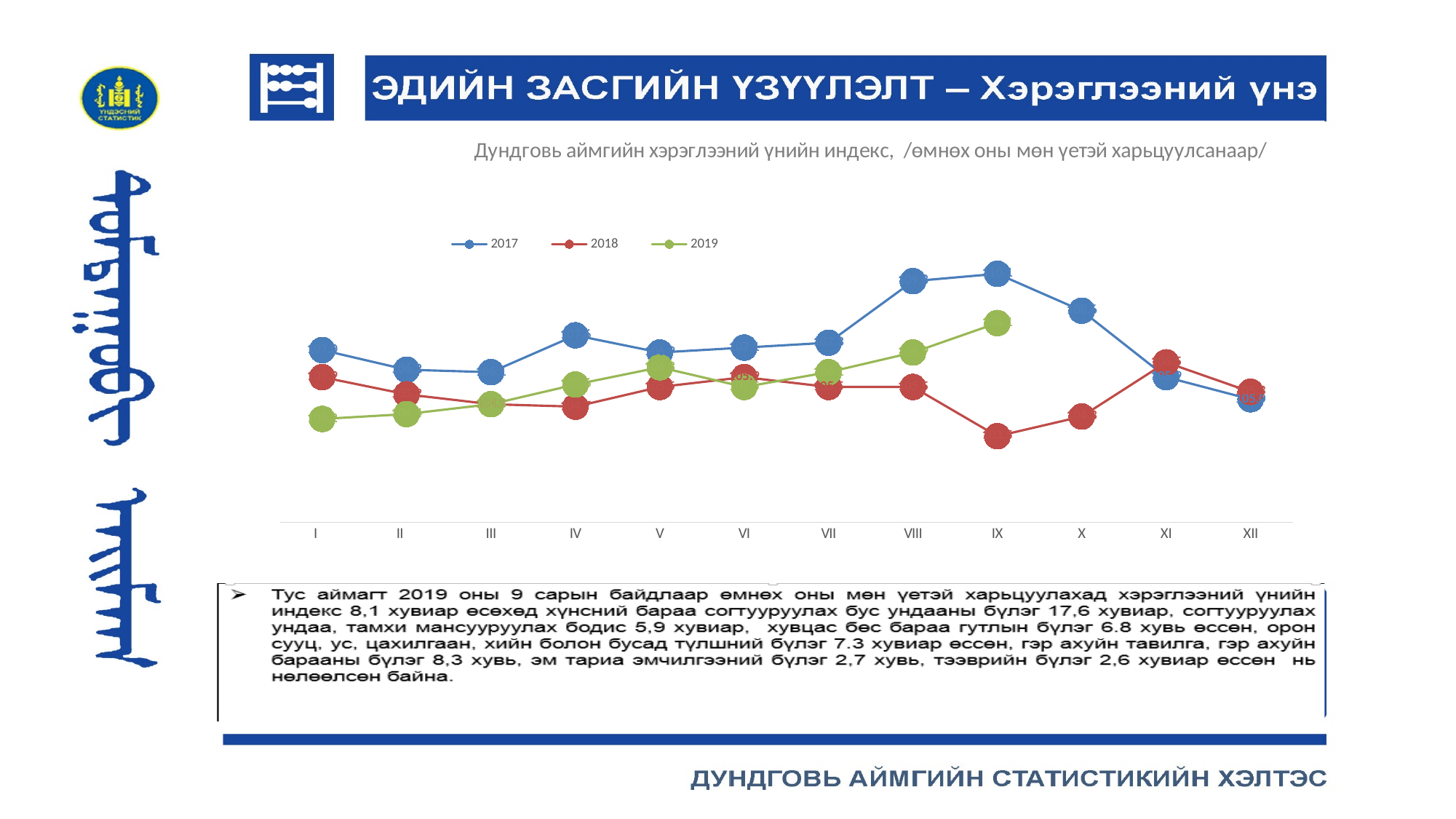
Which years are listed in the chart legend? 2017, 2018, 2019 In month IX, which series has the higher value, 2017 or 2018? 2017 In which month does the 2018 series reach its lowest value? IX In which month does the 2017 series reach its lowest value? XII How many data points does the 2019 series have? 9 In which month does the 2019 series reach its highest value? IX In month XI, which series has the higher value, 2017 or 2018? 2018 How many categories (months) are shown on the x axis of the chart? 12 How many series does the chart legend list? 3 What kind of chart is shown on the slide? Line chart In which month does the 2017 series reach its highest value? IX Does the 2019 series generally rise or fall from month I to month IX? Rise